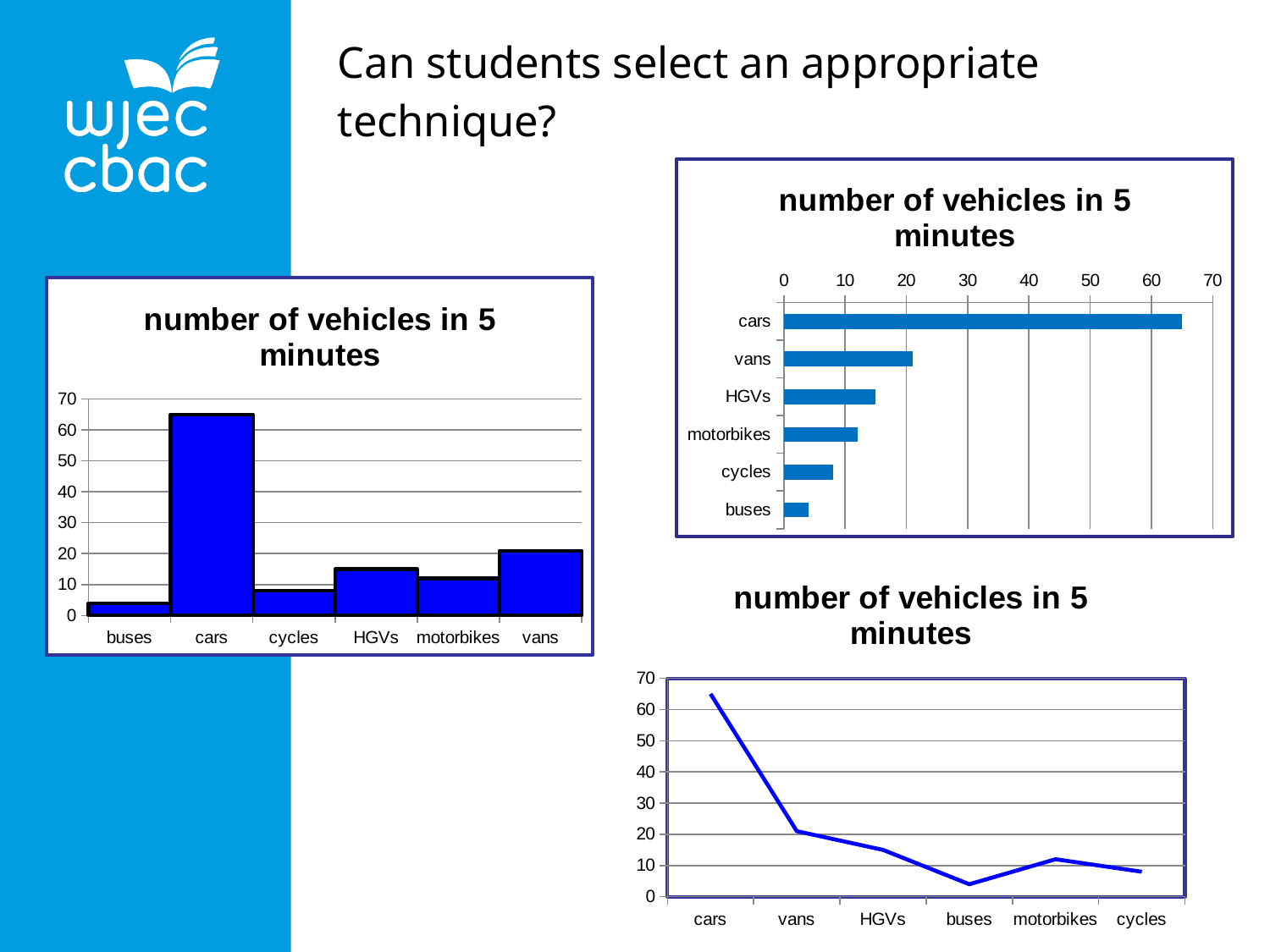
In the chart on the left of the slide, which category has the lowest value? buses In the chart at the top right of the slide, is the value for buses greater or less than 10? less What is the title of the chart on the left of the slide? number of vehicles in 5 minutes In the chart on the left of the slide, which is larger, the value for vans or the value for HGVs? vans In the chart at the top right of the slide, is the value for cars greater or less than 60? greater In the chart on the left of the slide, which category has the highest value? cars What kind of chart is the chart at the top right of the slide? bar chart In the chart at the bottom right of the slide, does the line rise or fall from cars to buses? falls What kind of chart is the chart on the left of the slide? bar chart In the chart on the left of the slide, is the value for HGVs greater or less than 20? less How many categories are shown on the x axis of the chart on the left of the slide? 6 What kind of chart is the chart at the bottom right of the slide? line chart